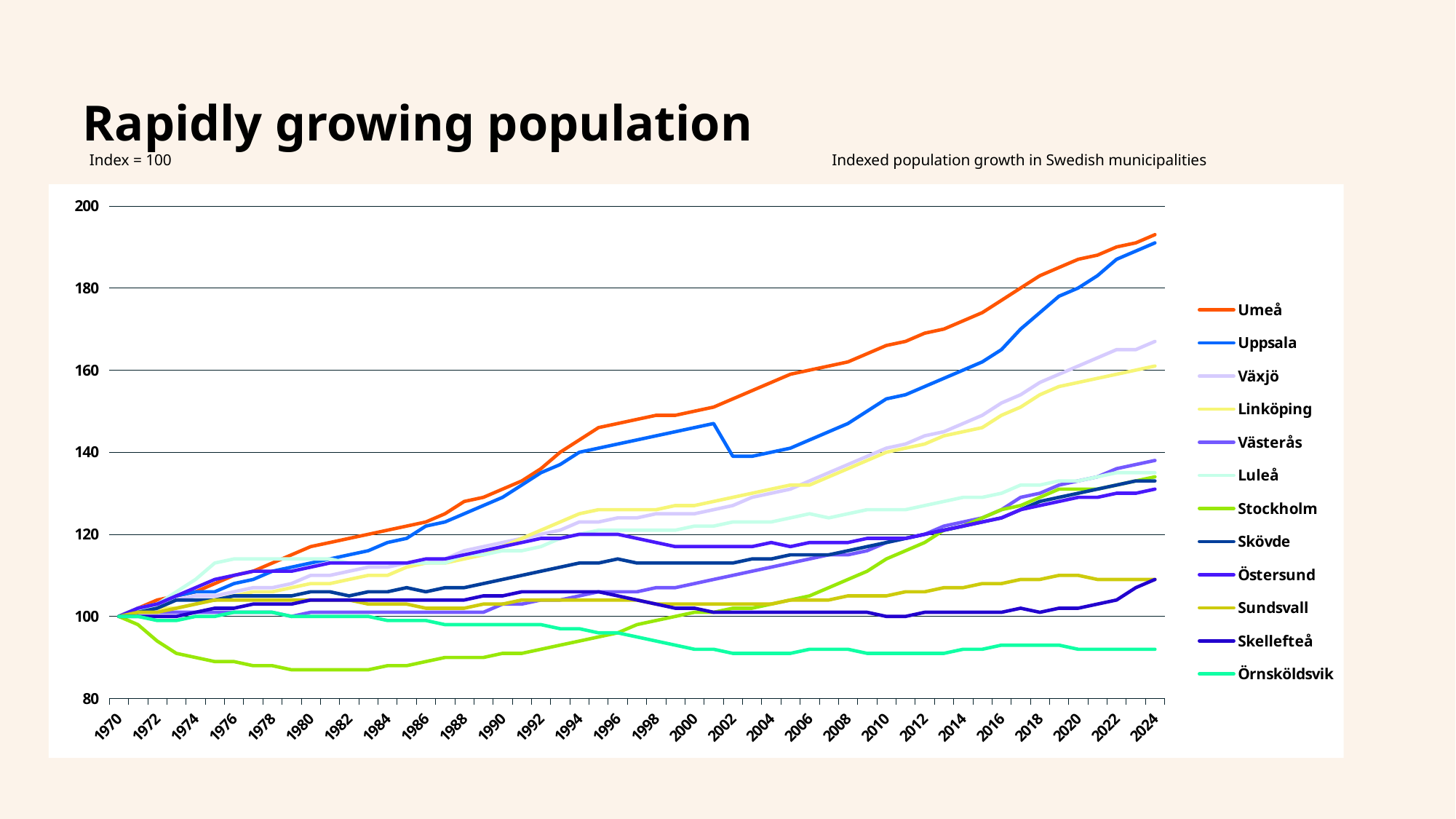
Is the value for Sundsvall in 2024 greater or less than 120? less Is the value for Umeå in 2024 greater or less than 180? greater Which municipality has the lowest index value in 2024? Örnsköldsvik What kind of chart is shown on the slide? line chart What is the title of the slide? Rapidly growing population Does the line for Umeå rise or fall from 1970 to 2024? rise Is the value for Örnsköldsvik in 2024 greater or less than 100? less How many municipalities does the legend list? 12 What is the index value for all municipalities in the base year 1970? 100 In 2024, which is larger, the value for Uppsala or the value for Linköping? Uppsala Which municipality has the highest index value in 2024? Umeå